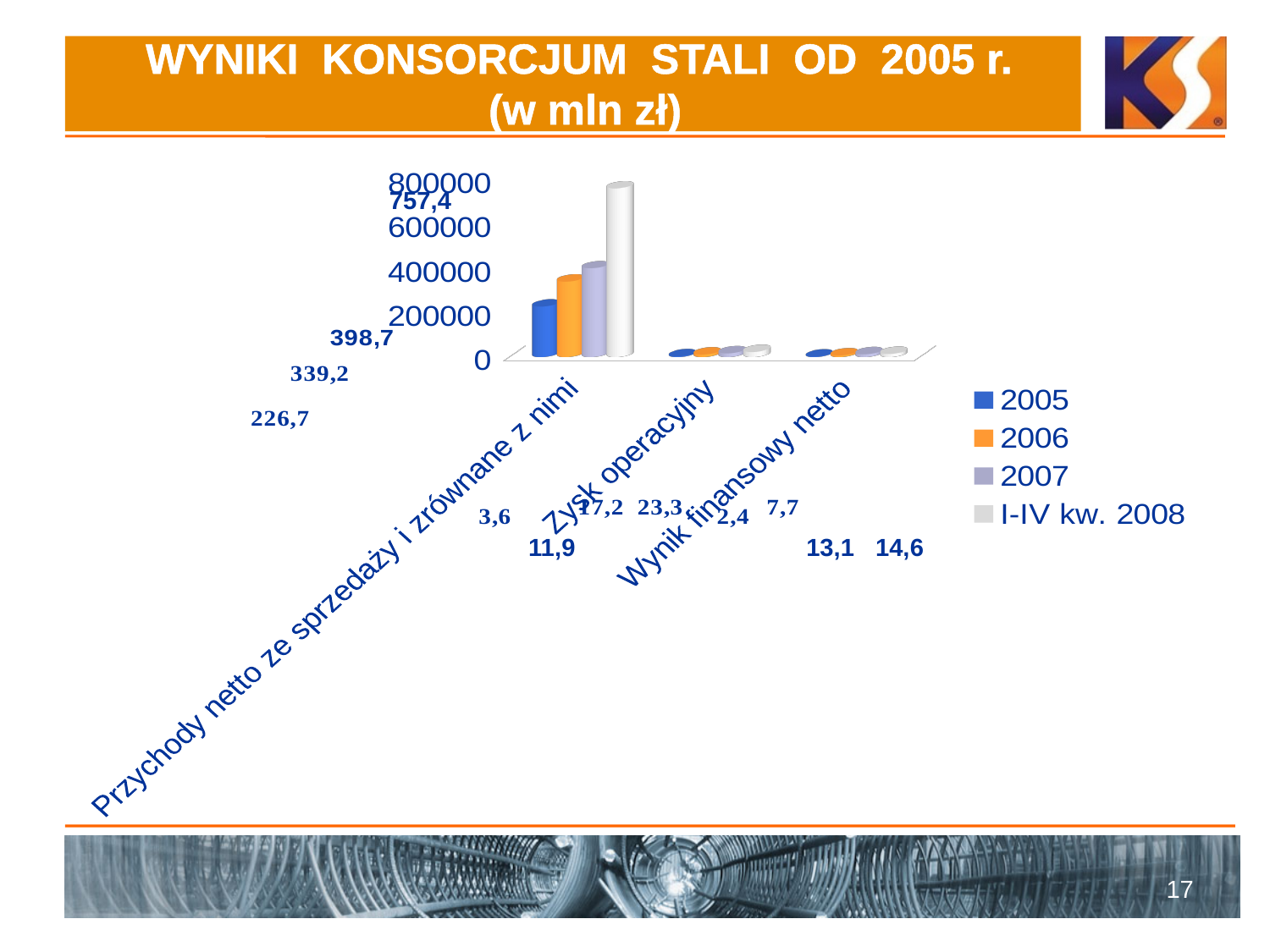
Do the bars for 'Przychody netto ze sprzedaży i zrównane z nimi' rise or fall from 2005 to I-IV kw. 2008? rise Which series has the tallest bar for 'Przychody netto ze sprzedaży i zrównane z nimi'? I-IV kw. 2008 Which category has the tallest bars overall? Przychody netto ze sprzedaży i zrównane z nimi Is the I-IV kw. 2008 bar for 'Przychody netto ze sprzedaży i zrównane z nimi' greater or less than 600000? greater Is the 2005 bar for 'Przychody netto ze sprzedaży i zrównane z nimi' greater or less than 400000? less How many series does the legend list? 4 Which series has the shortest bar for 'Przychody netto ze sprzedaży i zrównane z nimi'? 2005 What kind of chart is shown on the slide? bar chart Which series is listed last in the legend? I-IV kw. 2008 What is the highest value shown on the vertical axis? 800000 How many categories are shown on the x axis of the chart? 3 Which is larger for 'Przychody netto ze sprzedaży i zrównane z nimi': the 2006 bar or the 2007 bar? 2007